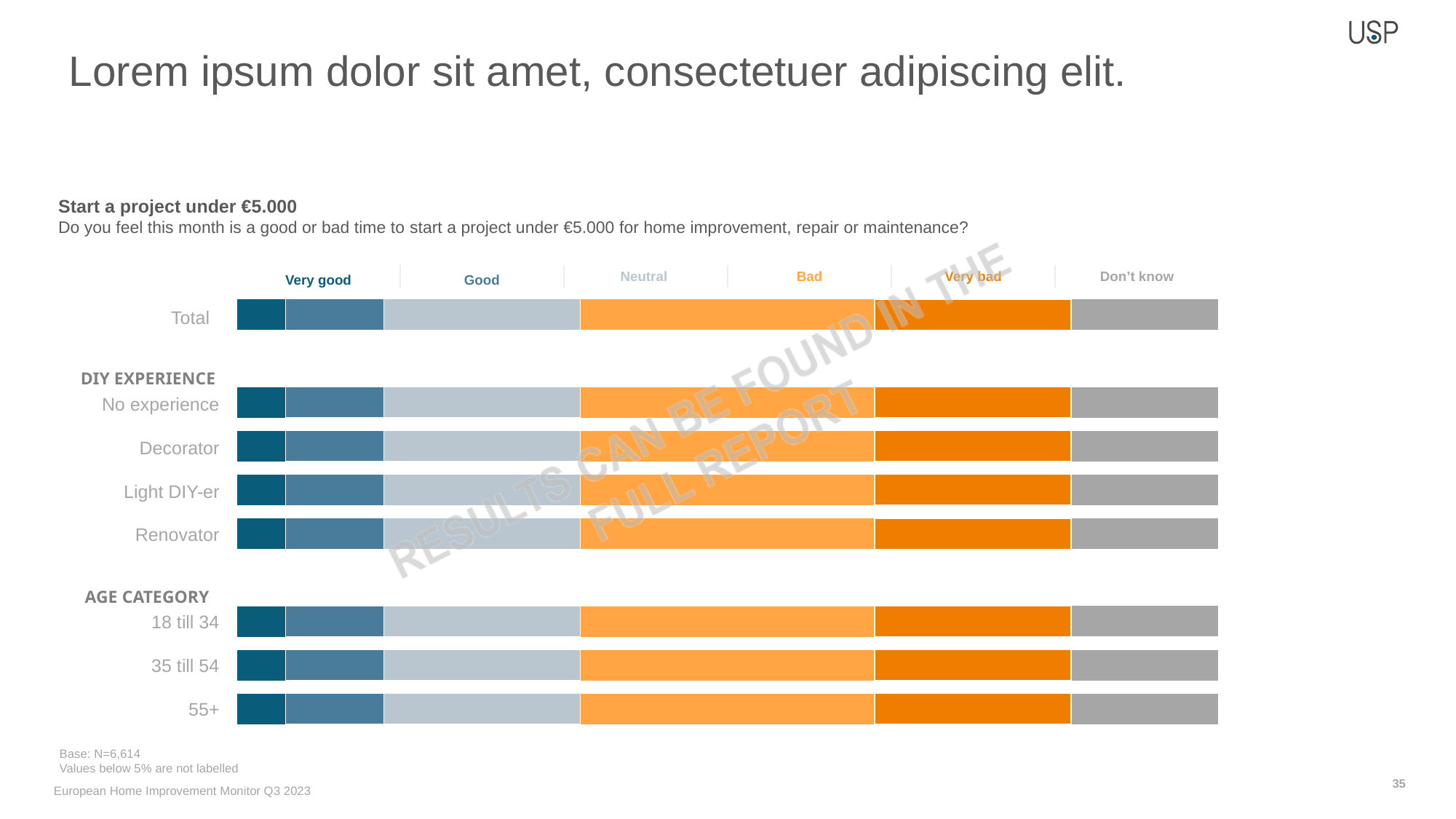
Which response segment is the narrowest in the Total bar? Very good What is the title of the chart? Start a project under €5.000 How many response categories does the legend list? 6 Which response segment is the widest in the Total bar? Bad Which response category is listed first in the legend? Very good What is the base sample size stated below the chart? N=6,614 What kind of chart is shown on the slide? Stacked bar chart How many bars are plotted in the chart? 8 In the Total bar, is the Bad segment wider or narrower than the Neutral segment? Wider Which age category is the last bar in the chart? 55+ How many bars are shown under the DIY EXPERIENCE group? 4 How many bars are shown under the AGE CATEGORY group? 3